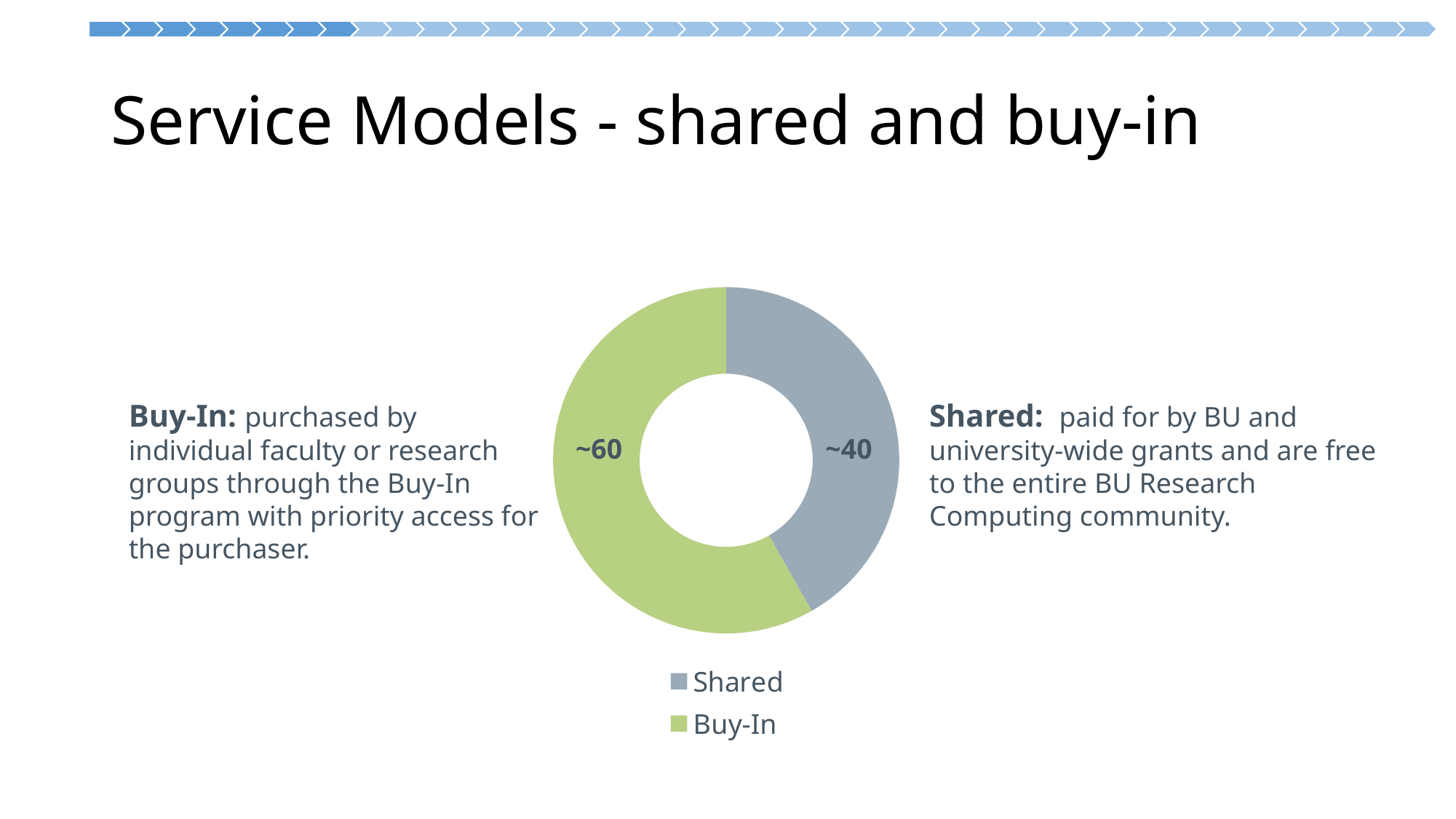
Which category has the largest slice in the doughnut chart? Buy-In What data label is printed on the Buy-In slice? ~60 Which category has the smallest slice in the doughnut chart? Shared What data label is printed on the Shared slice? ~40 What kind of chart is shown on the slide? doughnut chart How many slices does the doughnut chart have? 2 What colour is the Buy-In slice in the doughnut chart? green How many entries does the chart legend list? 2 Which slice is larger, Shared or Buy-In? Buy-In What are the two entries listed in the chart legend? Shared and Buy-In